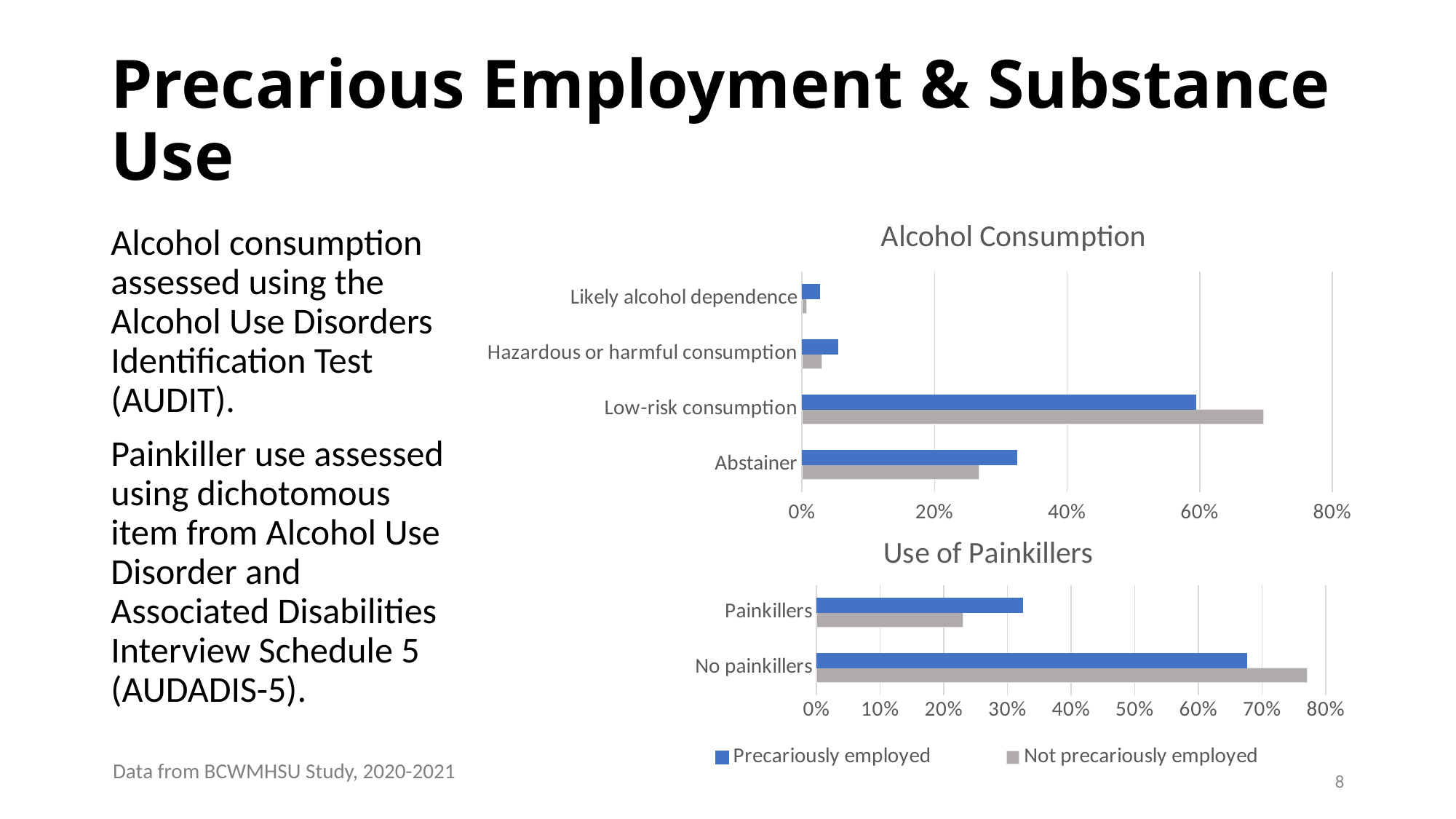
Which colour represents the Precariously employed series in the charts? blue In the "Alcohol Consumption" chart, which category has the lowest value for Not precariously employed? Likely alcohol dependence In the "Alcohol Consumption" chart, which category has the highest value for Not precariously employed? Low-risk consumption In the "Use of Painkillers" chart, for Painkillers, which series has the larger value: Precariously employed or Not precariously employed? Precariously employed In the "Alcohol Consumption" chart, for Low-risk consumption, which series has the larger value: Precariously employed or Not precariously employed? Not precariously employed How many series does the legend list for the charts? 2 How many categories are shown in the "Alcohol Consumption" chart? 4 In the "Use of Painkillers" chart, is the No painkillers value for Not precariously employed greater or less than 70%? greater How many categories are shown in the "Use of Painkillers" chart? 2 In the "Alcohol Consumption" chart, is the Low-risk consumption value for Precariously employed greater or less than 40%? greater What type of chart is the "Alcohol Consumption" chart? bar chart In the "Alcohol Consumption" chart, is the Abstainer value for Not precariously employed greater or less than 40%? less